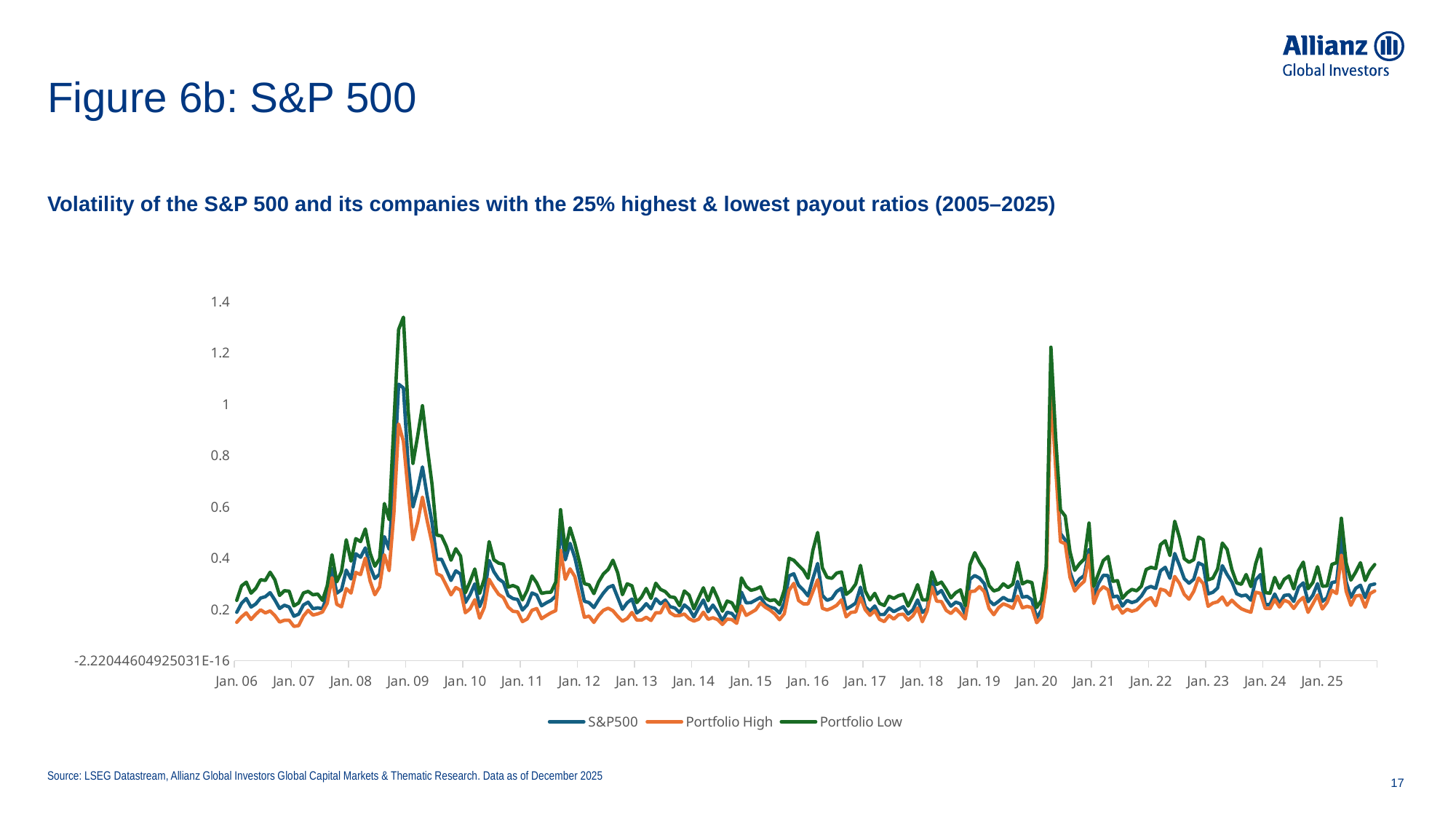
What is the first year label on the x axis? Jan. 06 How many year labels are shown on the x axis? 20 Which series reaches the highest peak on the chart? Portfolio Low What are the three series named in the legend? S&P500, Portfolio High, Portfolio Low What kind of chart is shown on the slide? Line chart Is the peak value of Portfolio Low around Jan. 09 greater or less than 1.2? greater Is the peak value of S&P500 around Jan. 09 greater or less than 1? greater Which colour is used for the Portfolio Low line? Green How many series does the legend list? 3 Is the peak value of Portfolio High around Jan. 09 greater or less than 1? less Around Jan. 09, which series is larger: Portfolio Low or Portfolio High? Portfolio Low Which series generally runs lowest across the chart? Portfolio High